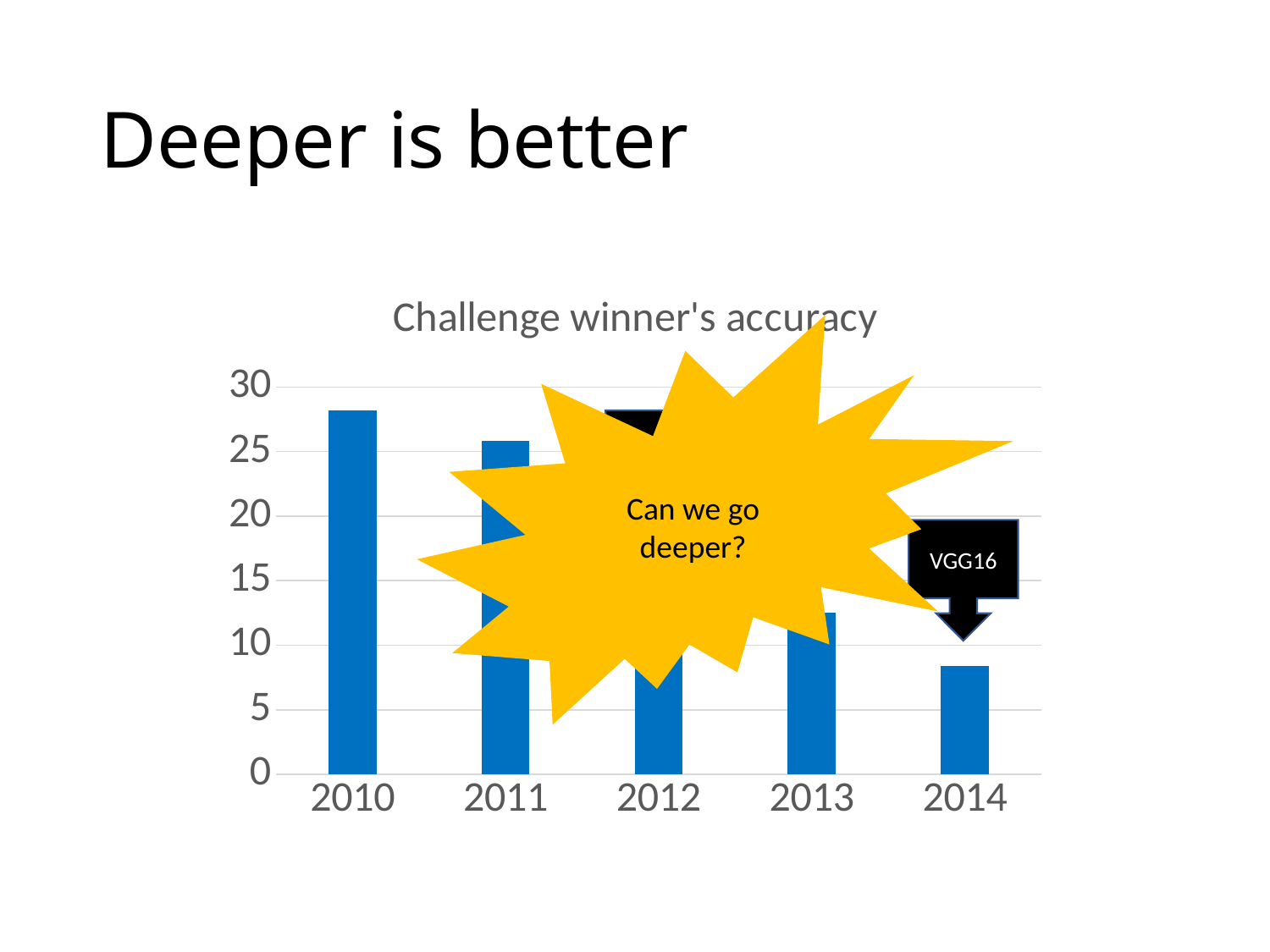
Which year's bar does the black callout labelled VGG16 point to? 2014 Which year has the highest bar in the chart? 2010 Do the values rise or fall from 2010 to 2014? fall What kind of chart is shown on the slide? bar chart What is the title of the chart? Challenge winner's accuracy Is the value for 2014 greater or less than 10? less Is the value for 2011 greater or less than 20? greater How many years are shown on the x axis of the chart? 5 Is the value for 2010 greater or less than 25? greater Which is larger, the value for 2010 or the value for 2014? 2010 Which year has the lowest bar in the chart? 2014